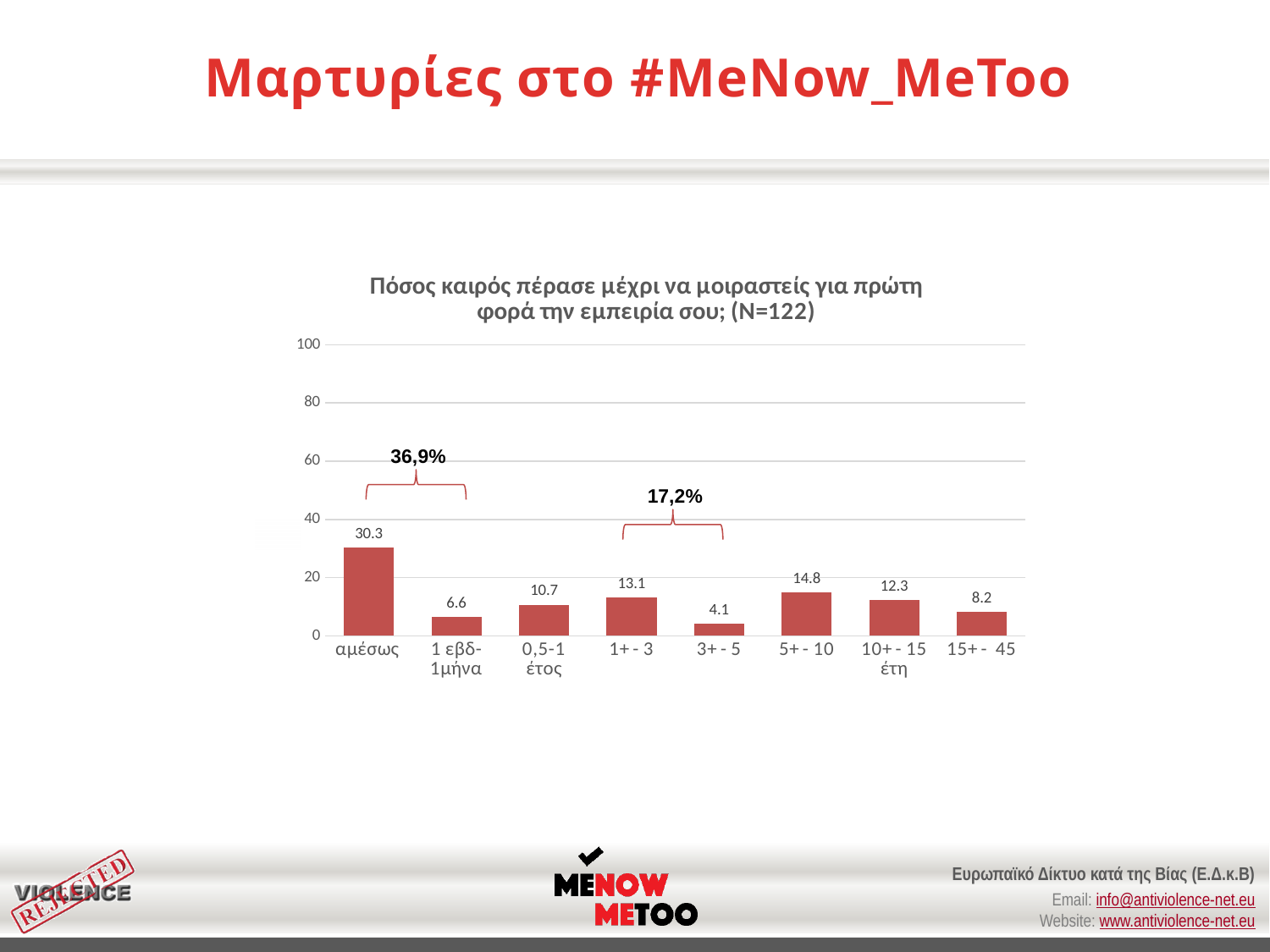
Which is larger, the value for '10+ - 15 έτη' or the value for '15+ - 45'? 10+ - 15 έτη What kind of chart is shown on the slide? bar chart What is the difference between the values for 'αμέσως' and '1 εβδ-1μήνα'? 23.7 How many categories are shown on the x axis? 8 What is the value for the '3+ - 5' category? 4.1 Is the value for 'αμέσως' greater or less than 20? greater What is the sample size (N) stated in the chart title? 122 What is the value for the '5+ - 10' category? 14.8 What is the value for the 'αμέσως' category? 30.3 What percentage is shown by the bracket above the first two bars? 36,9% Which category has the highest value? αμέσως Which category has the lowest value? 3+ - 5